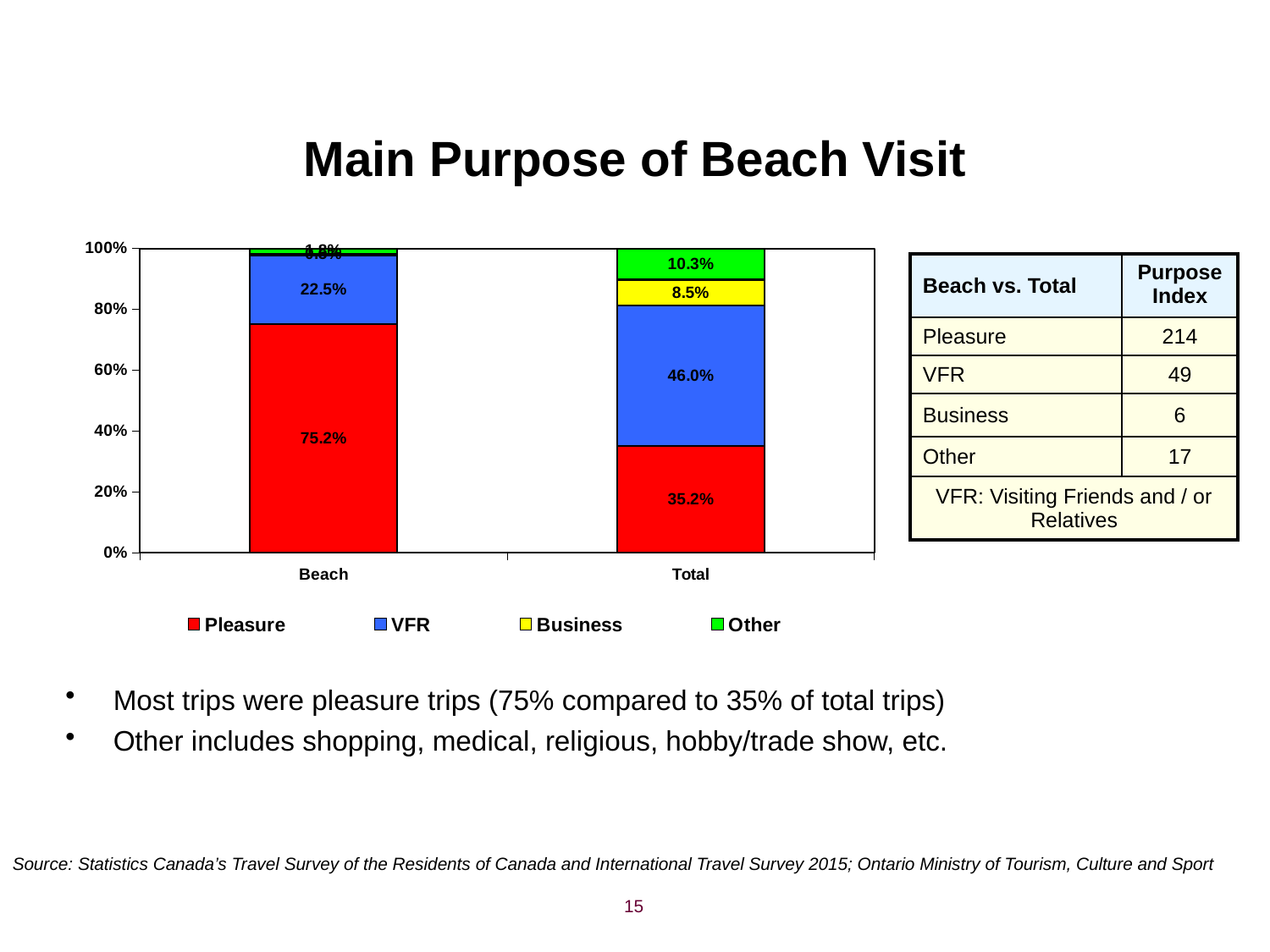
Which series is the largest segment in the Total bar? VFR Which colour represents Pleasure in the chart? Red What is the Pleasure share for the Beach bar? 75.2% How many series does the legend list? 4 Which bar has the higher Pleasure share, Beach or Total? Beach What is the Business share for the Total bar? 8.5% What kind of chart is shown on the slide? Stacked bar chart What is the difference between the Pleasure share for Beach and the Pleasure share for Total? 40.0% What is the VFR share for the Beach bar? 22.5% What is the Other share for the Total bar? 10.3% How many bars are shown on the x axis? 2 What is the VFR share for the Total bar? 46.0%